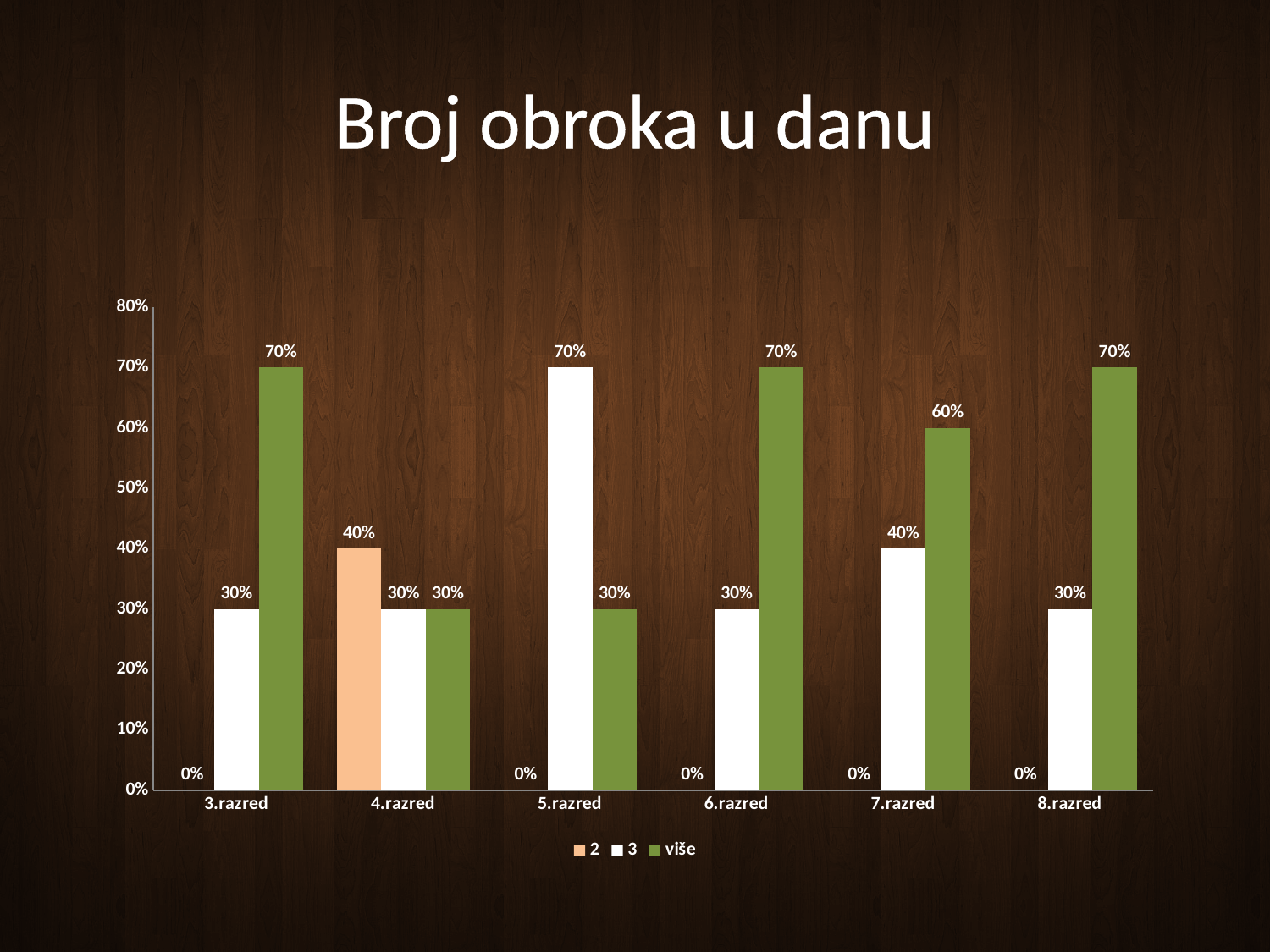
Which series has the highest value in 6.razred? više Which series has the lowest value in 7.razred? 2 What is the value for "2" in 4.razred? 40% What is the value for "više" in 7.razred? 60% What is the value for "više" in 3.razred? 70% In 5.razred, which is larger: the value for "3" or the value for "više"? 3 How many series does the legend list? 3 What is the difference between "više" and "3" in 8.razred? 40% How many categories (razred groups) are shown on the x axis? 6 What is the value for "3" in 5.razred? 70% What kind of chart is shown on the slide? bar chart What is the title of the chart? Broj obroka u danu